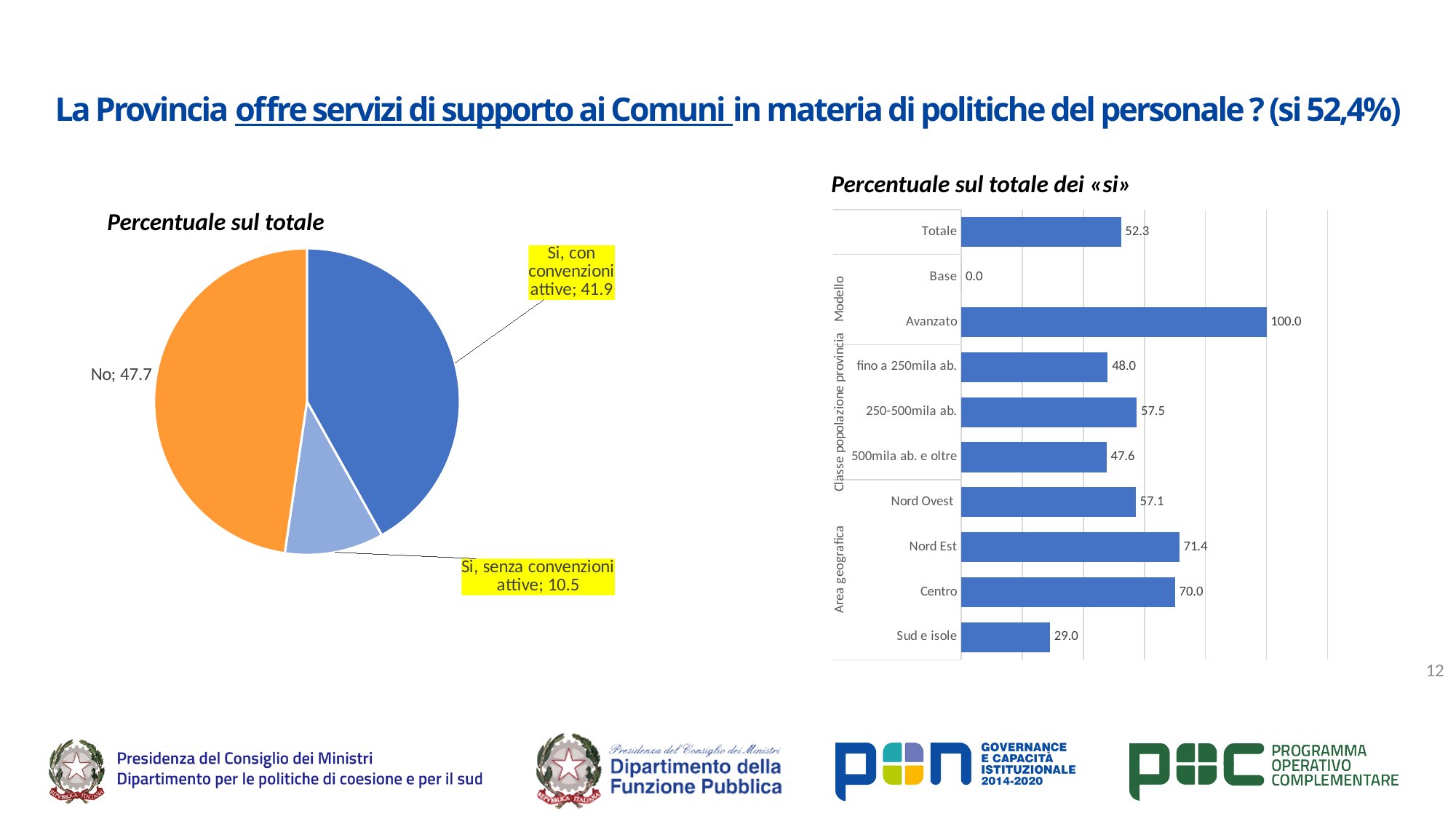
In the bar chart "Percentuale sul totale dei «si»", which category has the lowest value? Base In the pie chart "Percentuale sul totale", which slice is the smallest? Si, senza convenzioni attive In the chart titled "Percentuale sul totale dei «si»", what kind of chart is shown? bar chart In the pie chart "Percentuale sul totale", how many slices are there? 3 In the bar chart "Percentuale sul totale dei «si»", which is larger, the value for "250-500mila ab." or the value for "500mila ab. e oltre"? 250-500mila ab. In the bar chart "Percentuale sul totale dei «si»", what is the difference between the values for "Nord Est" and "Sud e isole"? 42.4 In the pie chart "Percentuale sul totale", what is the value for "Si, senza convenzioni attive"? 10.5 In the pie chart "Percentuale sul totale", what is the value for "No"? 47.7 In the bar chart "Percentuale sul totale dei «si»", which category has the highest value? Avanzato In the bar chart "Percentuale sul totale dei «si»", what is the value for "Totale"? 52.3 In the bar chart "Percentuale sul totale dei «si»", what is the value for "Nord Est"? 71.4 In the chart titled "Percentuale sul totale", what kind of chart is shown? pie chart